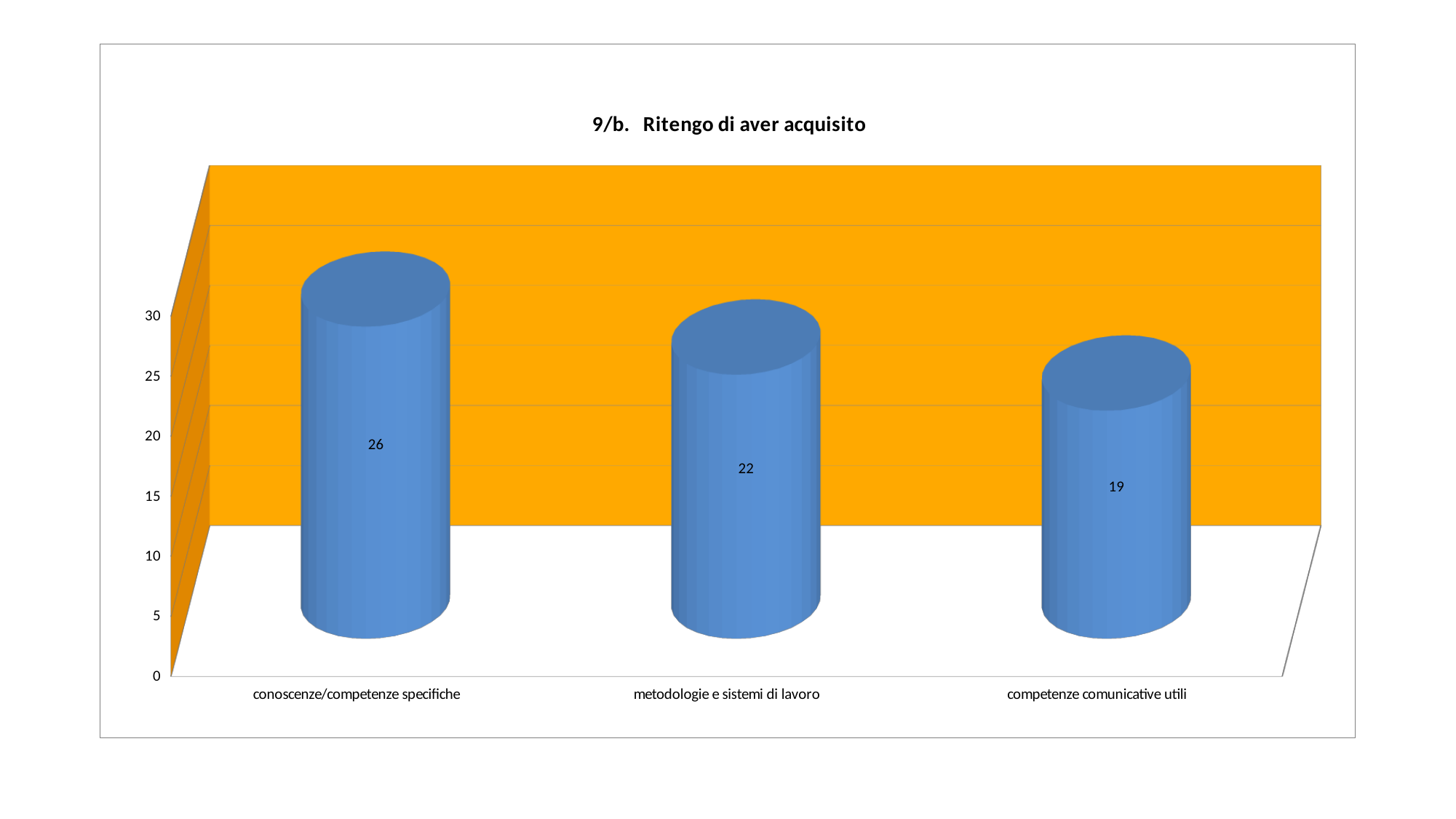
Do the values rise or fall from left to right along the x axis? fall What is the value for competenze comunicative utili? 19 Which is larger, the value for metodologie e sistemi di lavoro or the value for competenze comunicative utili? metodologie e sistemi di lavoro What is the difference between the values for metodologie e sistemi di lavoro and competenze comunicative utili? 3 What is the value for conoscenze/competenze specifiche? 26 How many categories are shown on the x axis? 3 Which category has the highest value? conoscenze/competenze specifiche Which category has the lowest value? competenze comunicative utili What is the value for metodologie e sistemi di lavoro? 22 What is the title of the chart? 9/b. Ritengo di aver acquisito What is the difference between the values for conoscenze/competenze specifiche and competenze comunicative utili? 7 What kind of chart is this? bar chart